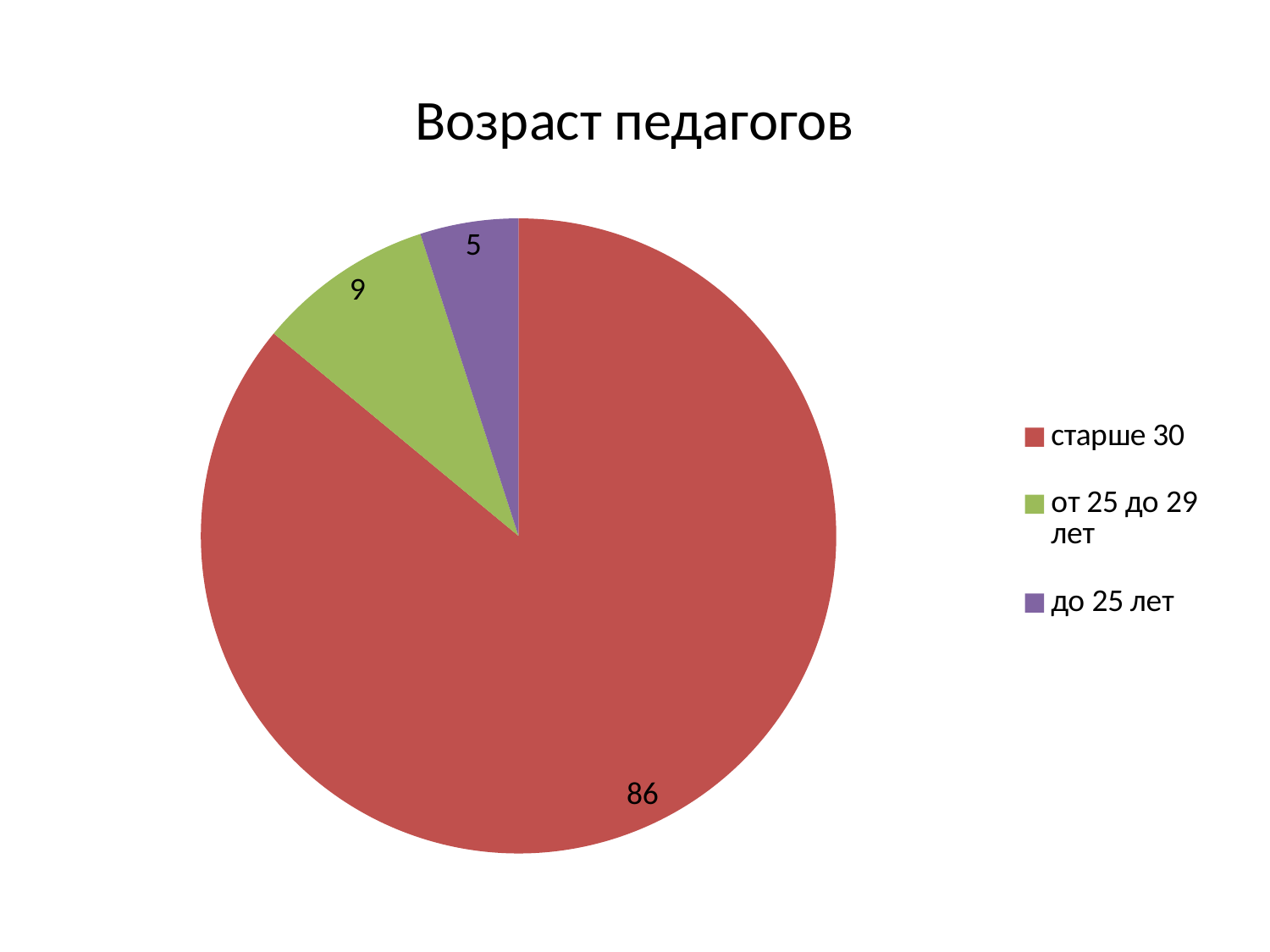
Which category has the smallest slice? до 25 лет What is the value for the "от 25 до 29 лет" slice? 9 What share of the pie does the "старше 30" slice represent? 86% What is the title of the chart? Возраст педагогов What is the value for the "до 25 лет" slice? 5 What is the difference between the values for "старше 30" and "от 25 до 29 лет"? 77 Which category has the largest slice? старше 30 How many slices does the pie chart have? 3 What is the difference between the values for "от 25 до 29 лет" and "до 25 лет"? 4 What type of chart is shown on the slide? pie chart What is the value for the "старше 30" slice? 86 Which is larger, the value for "от 25 до 29 лет" or the value for "до 25 лет"? от 25 до 29 лет